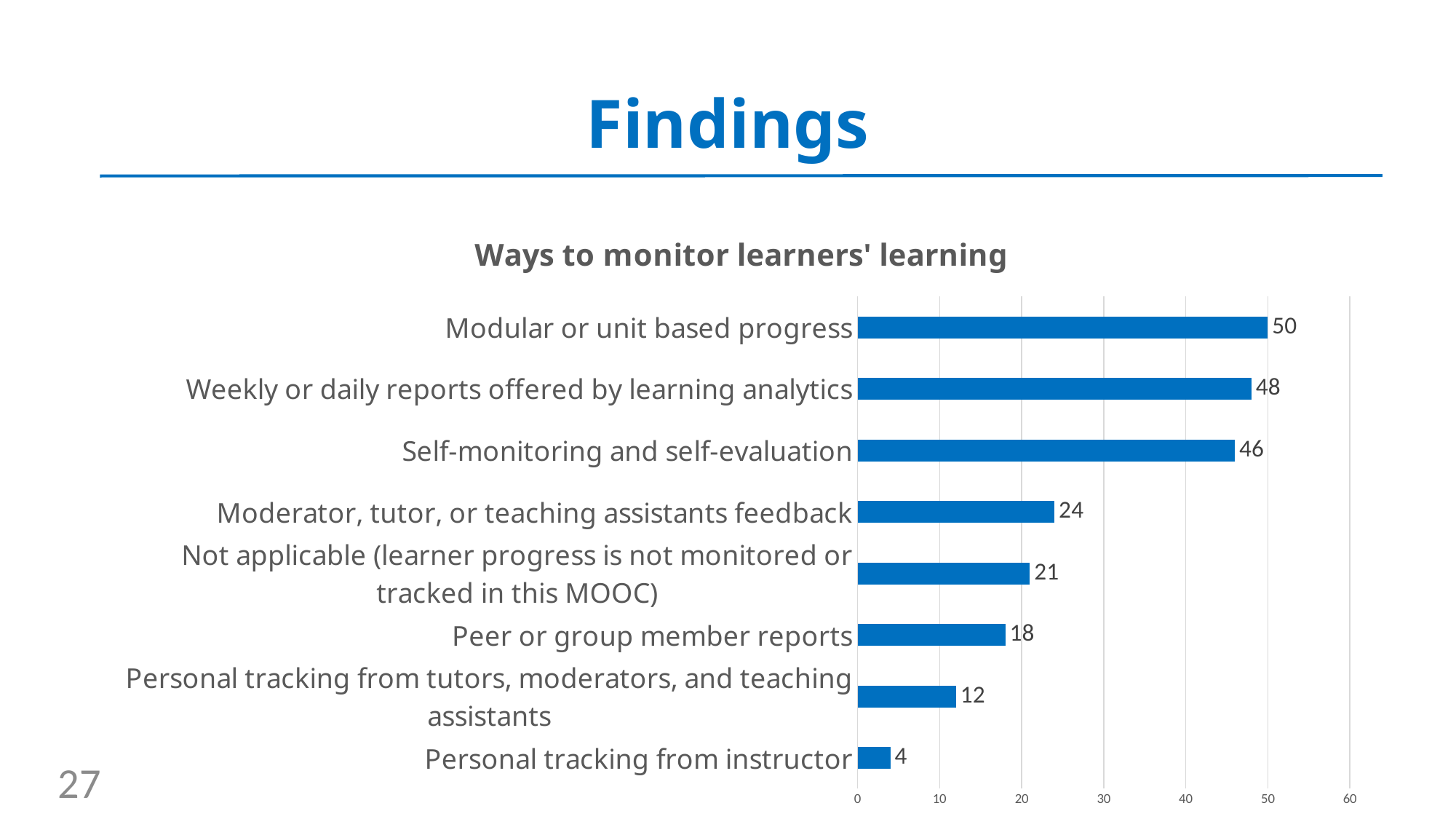
What is the difference between the values for Modular or unit based progress and Weekly or daily reports offered by learning analytics? 2 What kind of chart is shown on the slide? Bar chart How many categories are shown in the chart? 8 Which is larger: the value for Not applicable (learner progress is not monitored or tracked in this MOOC) or the value for Peer or group member reports? Not applicable (learner progress is not monitored or tracked in this MOOC) What is the value for Self-monitoring and self-evaluation? 46 Which category has the highest value? Modular or unit based progress What is the title of the chart? Ways to monitor learners' learning What is the value for Peer or group member reports? 18 What is the value for Personal tracking from instructor? 4 Which category has the lowest value? Personal tracking from instructor What is the value for Modular or unit based progress? 50 What is the difference between the values for Moderator, tutor, or teaching assistants feedback and Personal tracking from tutors, moderators, and teaching assistants? 12